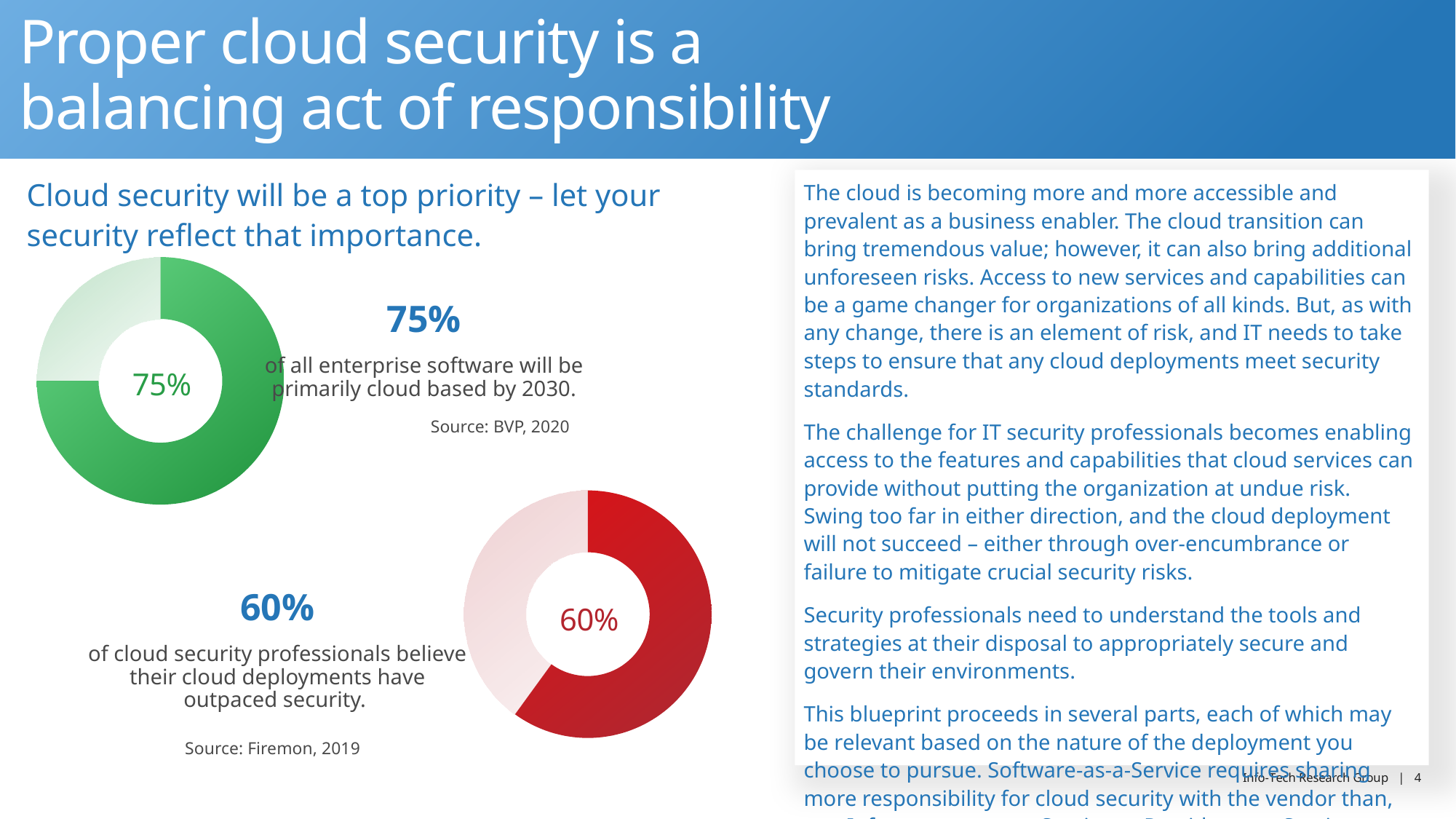
What source is cited for the statistic shown in the red donut chart? Firemon, 2019 In the red donut chart, what share of the ring is filled by the dark red segment? 60% Which chart shows the larger highlighted share, the green donut chart or the red donut chart? The green donut chart How many segments does the red donut chart have? 2 What is the difference between the value shown in the green donut chart and the value shown in the red donut chart? 15% What source is cited for the statistic shown in the green donut chart? BVP, 2020 How many segments does the green donut chart have? 2 What value is printed in the centre of the green donut chart? 75% What kind of chart is the red chart in the lower middle of the slide? Donut chart What kind of chart is the green chart on the left of the slide? Donut chart In the green donut chart, what share of the ring is filled by the dark green segment? 75% What value is printed in the centre of the red donut chart? 60%